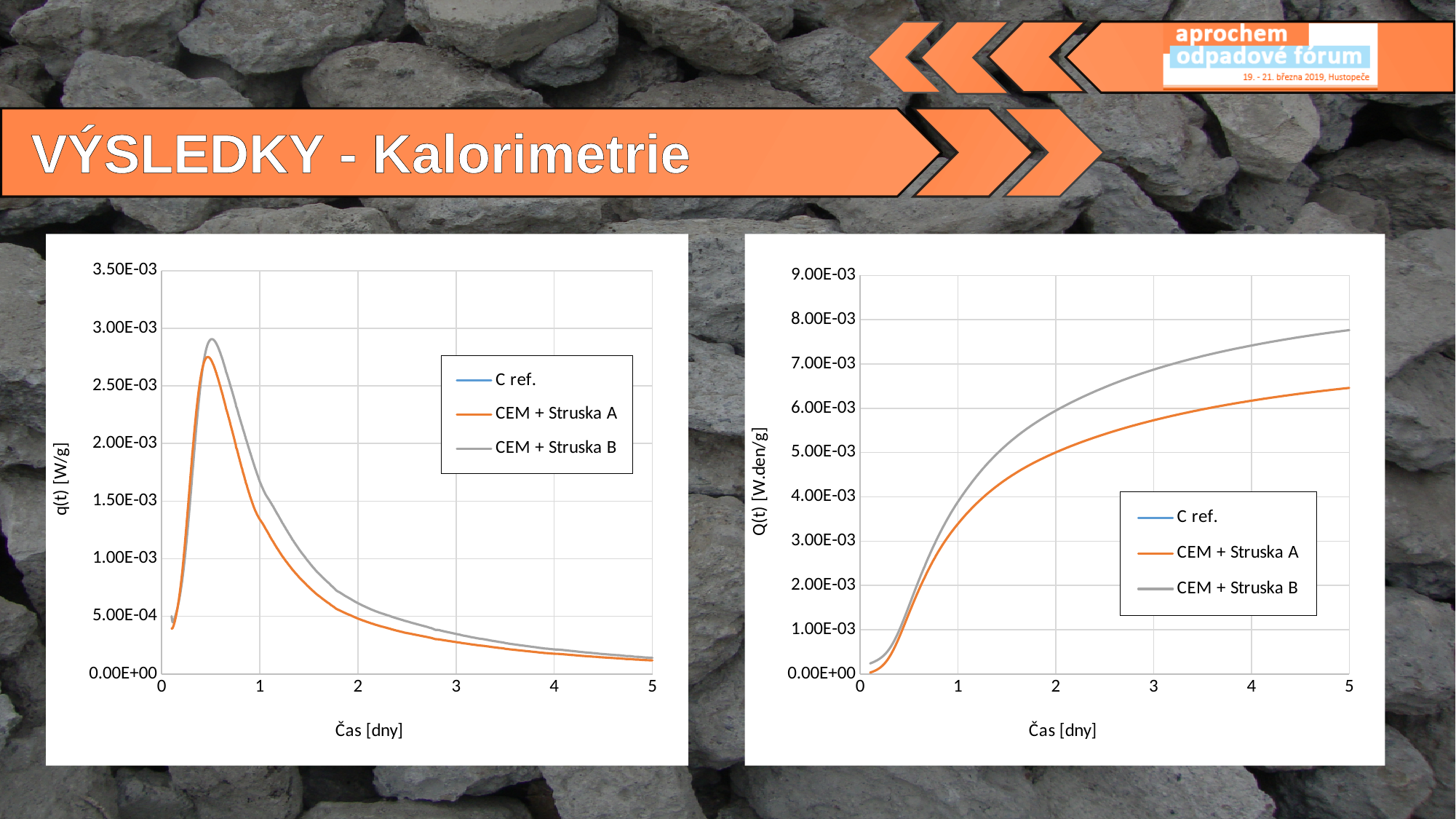
In the left chart, is the peak value of CEM + Struska B greater or less than 2.50E-03? greater In the right chart, do the values of CEM + Struska A rise or fall as time increases from 0 to 5 days? rise In the right chart, is the value of CEM + Struska B at day 5 greater or less than 7.00E-03? greater How many series does the legend of the right chart list? 3 In the right chart, is the value of CEM + Struska A at day 5 greater or less than 7.00E-03? less What is the y axis label of the left chart? q(t) [W/g] What kind of chart is the left chart with y axis q(t) [W/g]? line chart What kind of chart is the right chart with y axis Q(t) [W.den/g]? line chart How many series does the legend of the left chart list? 3 What is the x axis label of the right chart? Čas [dny] In the right chart, which series has the higher value at day 5, CEM + Struska A or CEM + Struska B? CEM + Struska B